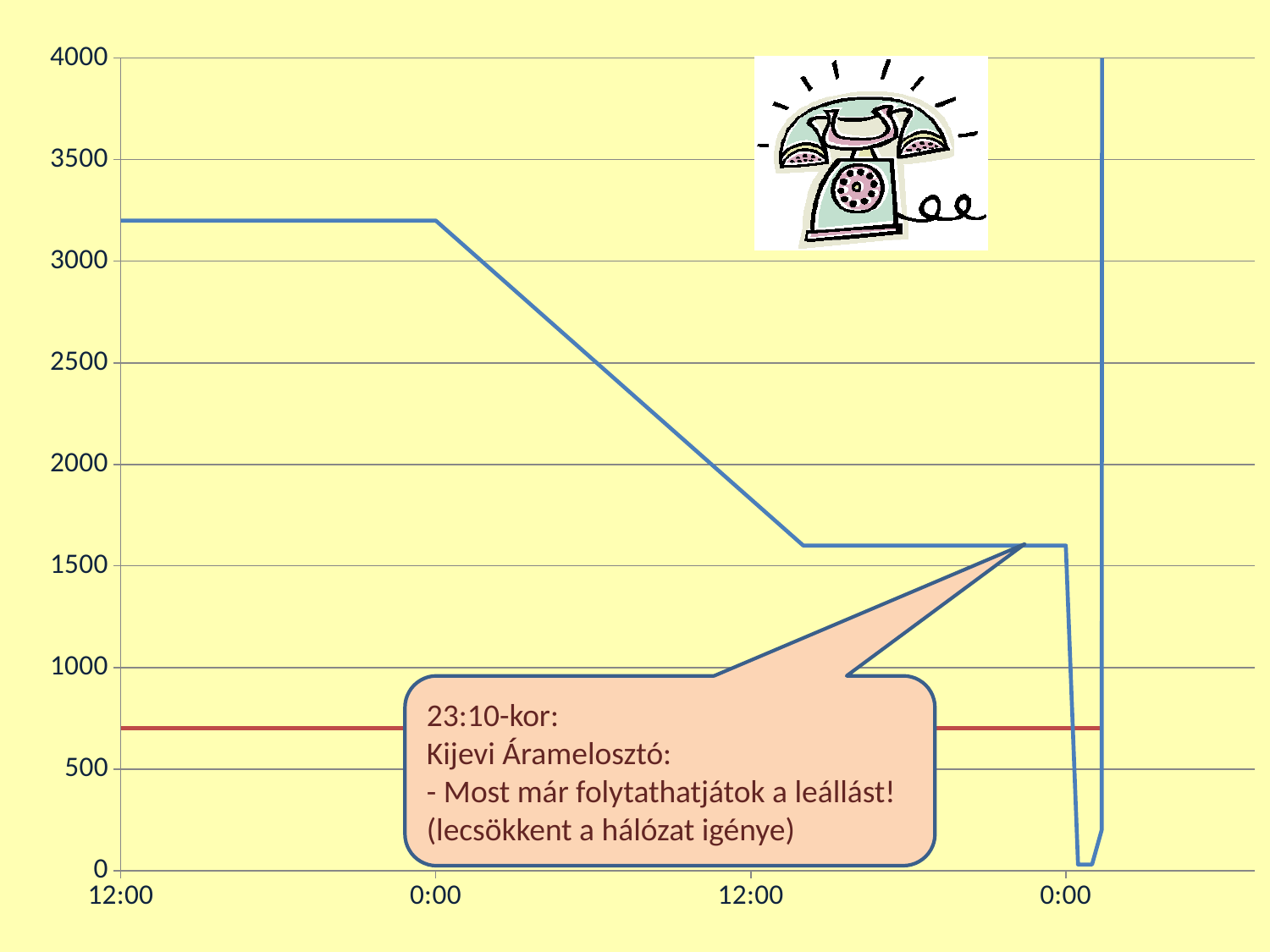
Is the value of the blue line at the second 12:00 tick greater or less than 1500? greater What time is mentioned at the start of the callout text on the chart? 23:10 How many time labels are shown on the horizontal axis? 4 Between the first 0:00 tick and the second 12:00 tick, does the blue line rise or fall? fall Is the value of the red horizontal line greater or less than 500? greater At the first 0:00 tick, is the blue line higher or lower than the red line? higher Between the leftmost 12:00 tick and the first 0:00 tick, does the blue line rise, fall, or stay flat? stay flat What kind of chart is shown on the slide? line chart Is the value of the red horizontal line greater or less than 1000? less